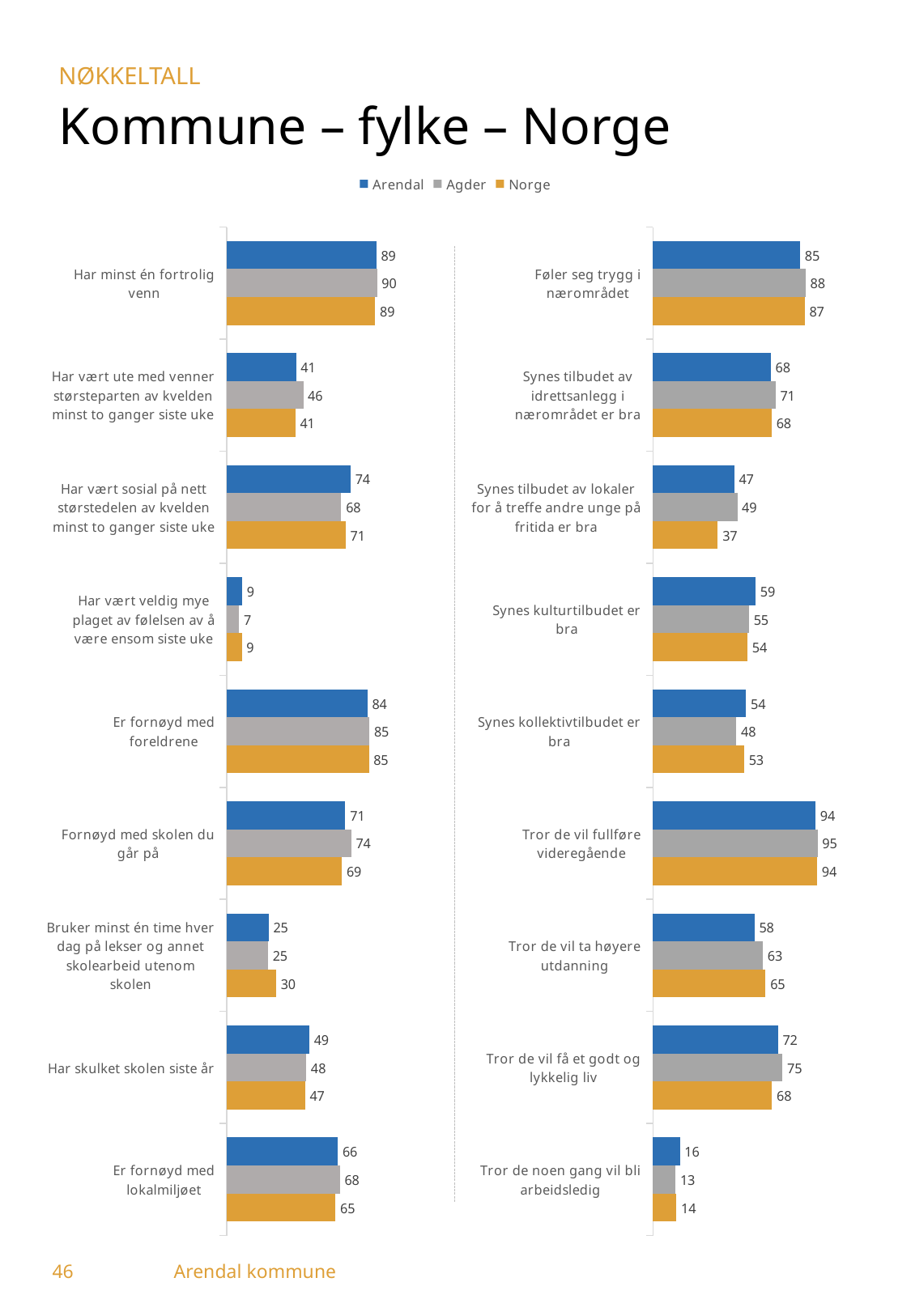
In the left chart, which category has the lowest Norge value? Har vært veldig mye plaget av følelsen av å være ensom siste uke In the right chart, for "Synes kollektivtilbudet er bra", which is larger: the Arendal value or the Agder value? Arendal In the left chart, what is the difference between the Norge and Arendal values for "Bruker minst én time hver dag på lekser og annet skolearbeid utenom skolen"? 5 How many series does the legend list? 3 In the right chart, what is the difference between the Agder and Norge values for "Tror de vil få et godt og lykkelig liv"? 7 In the left chart, what is the Arendal value for "Har vært sosial på nett størstedelen av kvelden minst to ganger siste uke"? 74 How many categories does the left chart show? 9 In the right chart, which category has the highest Arendal value? Tror de vil fullføre videregående What kind of chart is used on this slide? Bar chart In the right chart, what is the Norge value for "Synes tilbudet av lokaler for å treffe andre unge på fritida er bra"? 37 In the left chart, what is the Agder value for "Har vært ute med venner størsteparten av kvelden minst to ganger siste uke"? 46 In the right chart, for "Tror de vil ta høyere utdanning", which is larger: the Arendal value or the Norge value? Norge